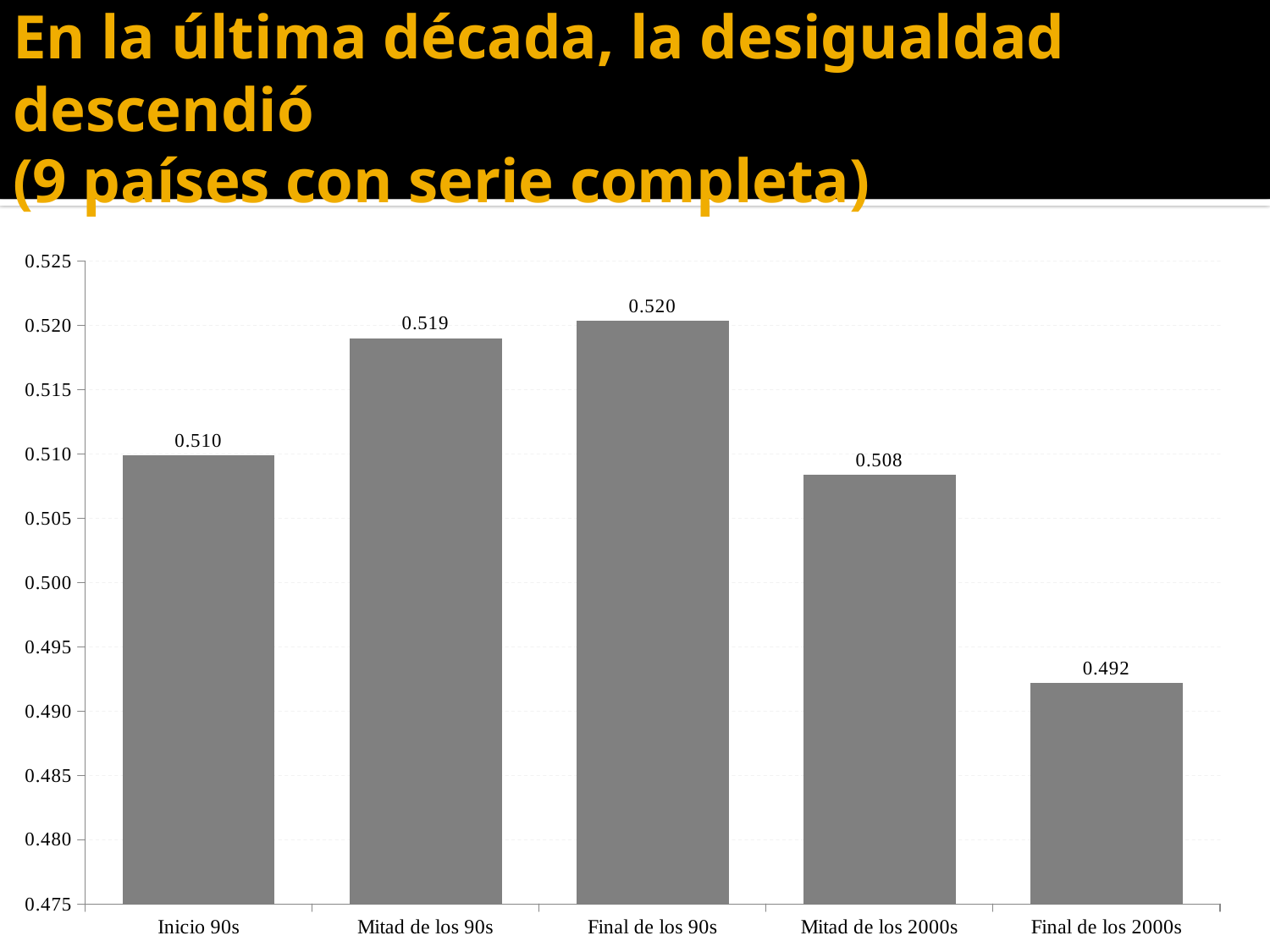
How many categories are shown on the x axis? 5 What is the difference between the values for Inicio 90s and Mitad de los 2000s? 0.002 Is the value for Final de los 2000s greater or less than 0.500? less What is the value for Final de los 2000s? 0.492 Which is larger, the value for Mitad de los 90s or the value for Mitad de los 2000s? Mitad de los 90s What is the value for Mitad de los 2000s? 0.508 What kind of chart is shown on the slide? bar chart What is the difference between the values for Final de los 90s and Final de los 2000s? 0.028 Do the values rise or fall from Final de los 90s to Final de los 2000s? fall Which category has the lowest value? Final de los 2000s What is the value for Inicio 90s? 0.510 Which category has the highest value? Final de los 90s